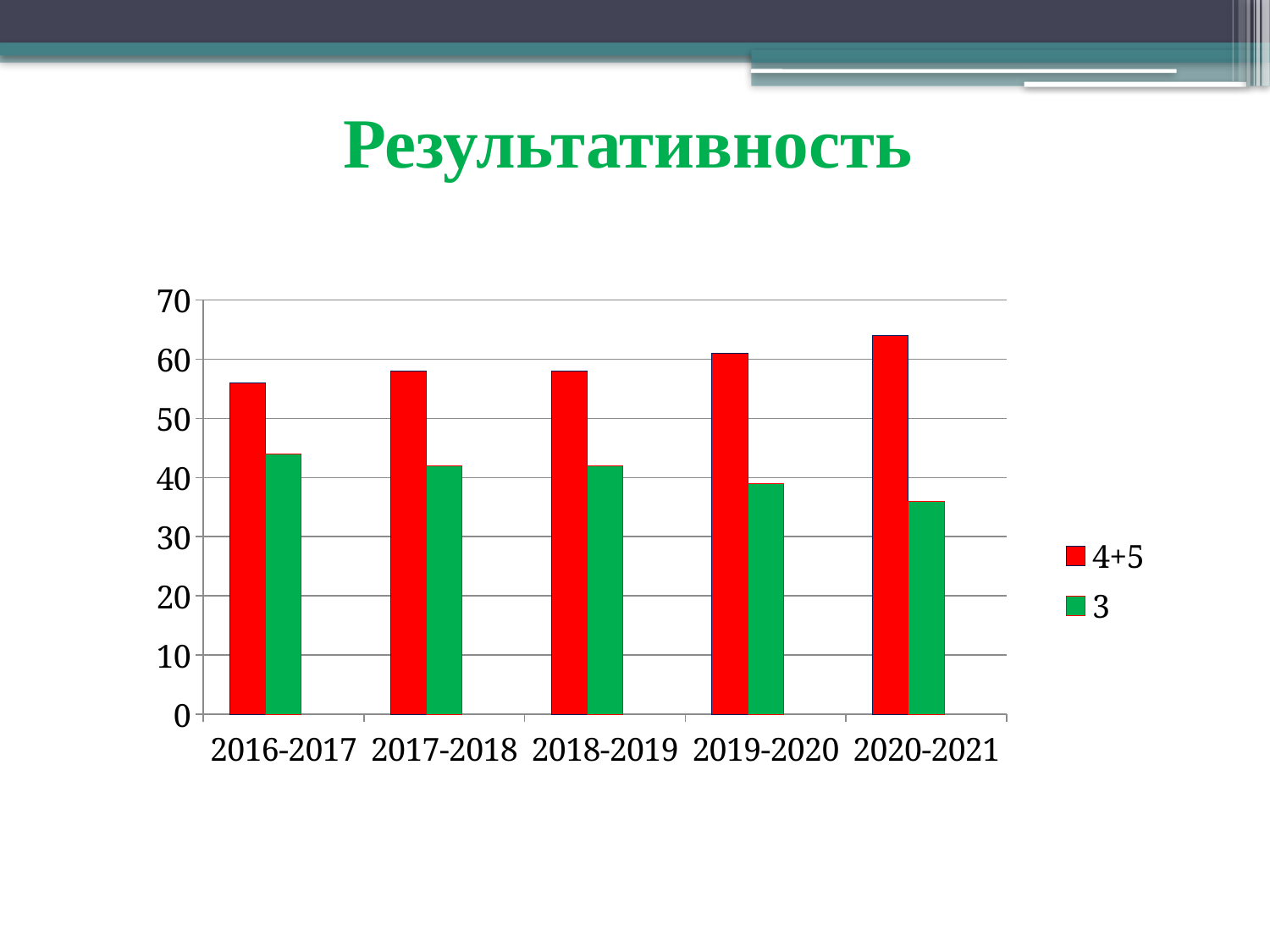
Which school year has the highest value for the 4+5 series? 2020-2021 Is the value for 3 in 2020-2021 greater or less than 40? less Is the value for 4+5 in 2020-2021 greater or less than 60? greater How many series does the legend list? 2 How many categories (school years) are shown on the x axis? 5 Do the values for the 4+5 series rise or fall from 2016-2017 to 2020-2021? rise In 2020-2021, which series has the larger value, 4+5 or 3? 4+5 Is the value for 3 in 2016-2017 greater or less than 40? greater What kind of chart is shown on the slide? bar chart What is the title of the chart on the slide? Результативность Which school year has the lowest value for the 3 series? 2020-2021